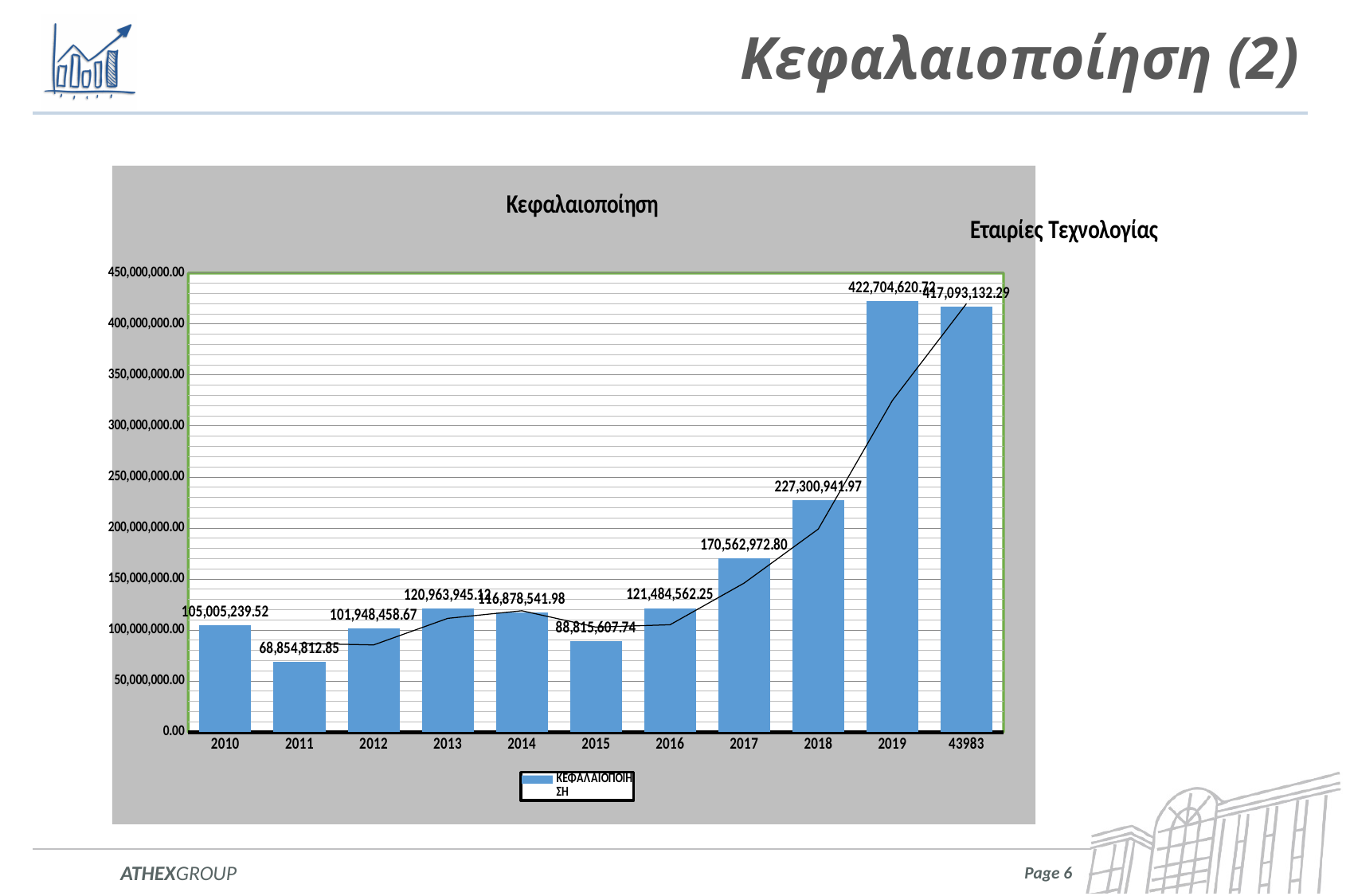
What is the difference between the values for 2018 and 2017? 56,737,969.17 Which category has the highest value? 2019 Which is larger, the value for 2016 or the value for 2014? 2016 What is the value for 2015? 88,815,607.74 Which category has the lowest value? 2011 What is the value for 2018? 227,300,941.97 What is the title of the chart? Κεφαλαιοποίηση What is the value for 2017? 170,562,972.80 How many categories are shown on the x axis? 11 What kind of chart is this? bar chart What is the value for 2010? 105,005,239.52 Is the value for 2017 greater or less than 150,000,000.00? greater